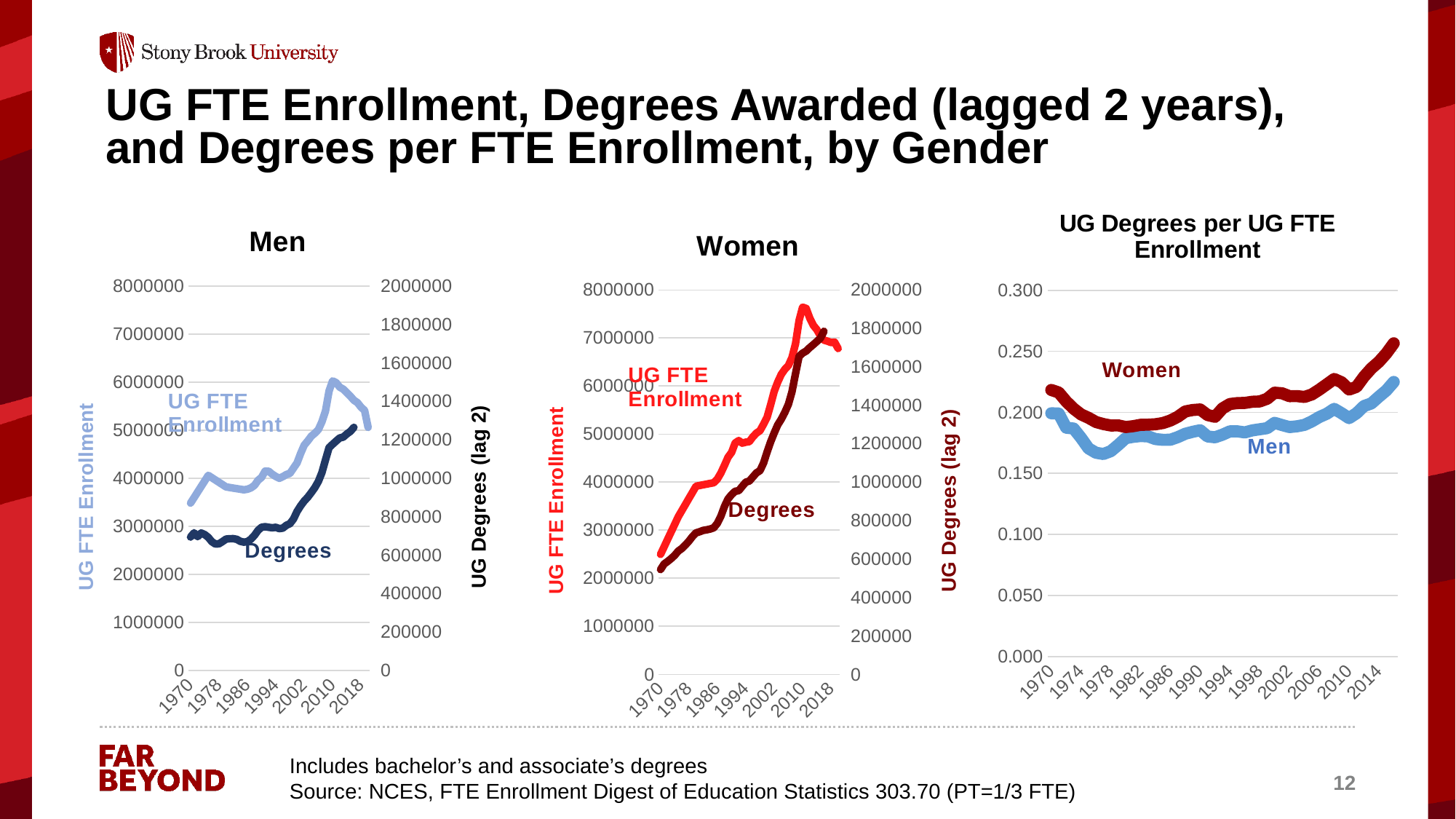
What is the label on the right-hand vertical axis of the "Women" chart? UG Degrees (lag 2) What type of chart is the "Men" chart? Line chart In the "UG Degrees per UG FTE Enrollment" chart, is the Men value around 1978 greater or less than 0.200? less How many year labels are shown on the x axis of the "UG Degrees per UG FTE Enrollment" chart? 12 How many data series are plotted in the "Women" chart? 2 In the "Women" chart, does the Degrees series generally rise or fall from 1970 to 2018? rise In the "Women" chart, is the peak UG FTE Enrollment value (around 2010) greater or less than 7000000? greater In the "Men" chart, is the UG FTE Enrollment value in 1970 greater or less than 4000000? less What is the title of the rightmost chart on the slide? UG Degrees per UG FTE Enrollment In the "UG Degrees per UG FTE Enrollment" chart, which series is higher in 2014, Women or Men? Women In the "Men" chart, does the UG FTE Enrollment series rise or fall between 2010 and 2018? fall